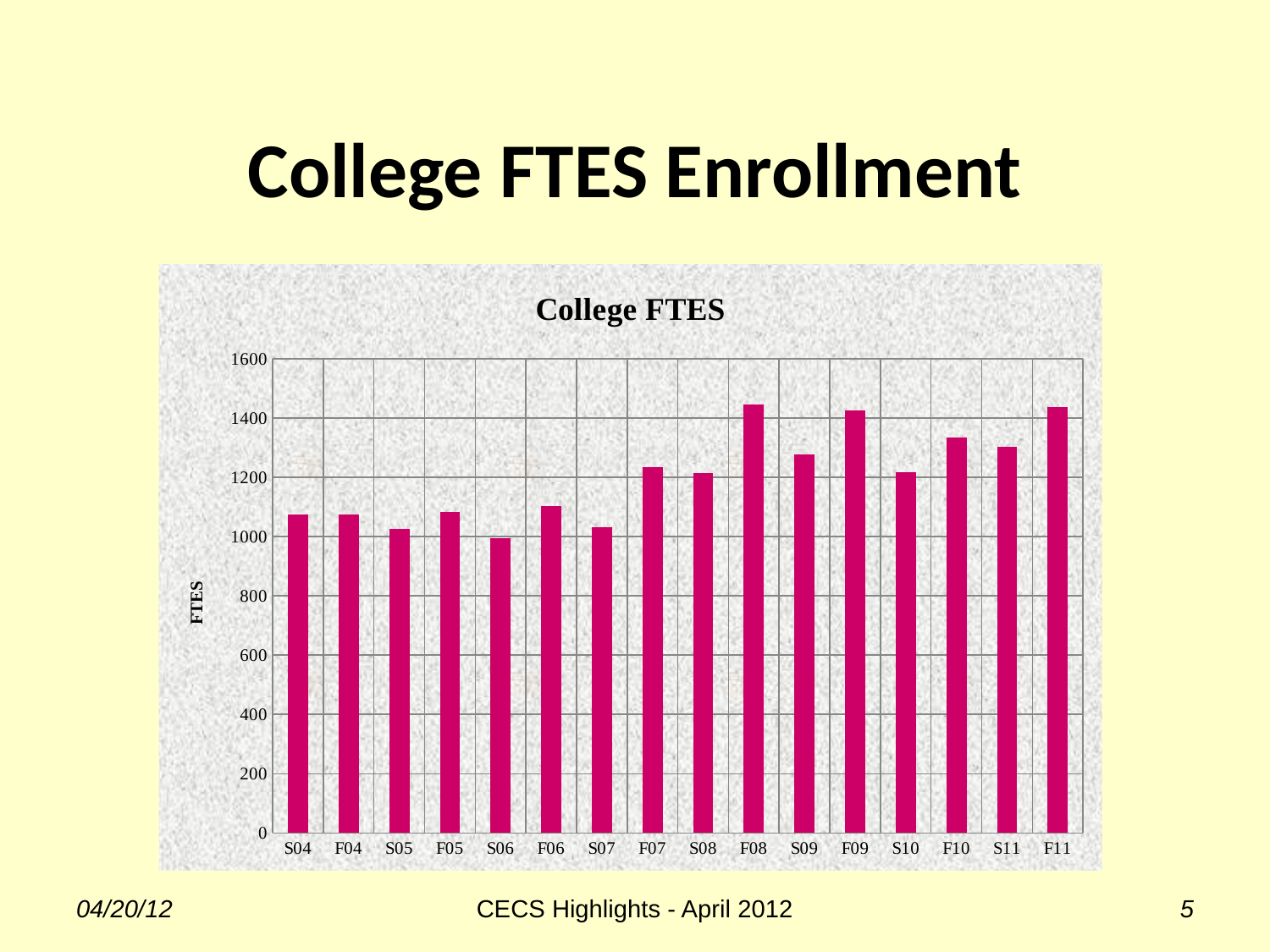
Which is larger, the FTES value for S07 or for F07? F07 Is the value for S04 greater or less than 1000? greater How many terms (categories) are plotted on the x axis of the College FTES chart? 16 Is the value for F07 greater or less than 1200? greater Which is larger, the FTES value for F08 or for S09? F08 What is the label on the vertical axis of the chart? FTES Which term has the lowest FTES value in the chart? S06 What kind of chart is shown on the slide? bar chart Overall, do the FTES values rise or fall from S04 to F11? rise Is the value for F08 greater or less than 1400? greater